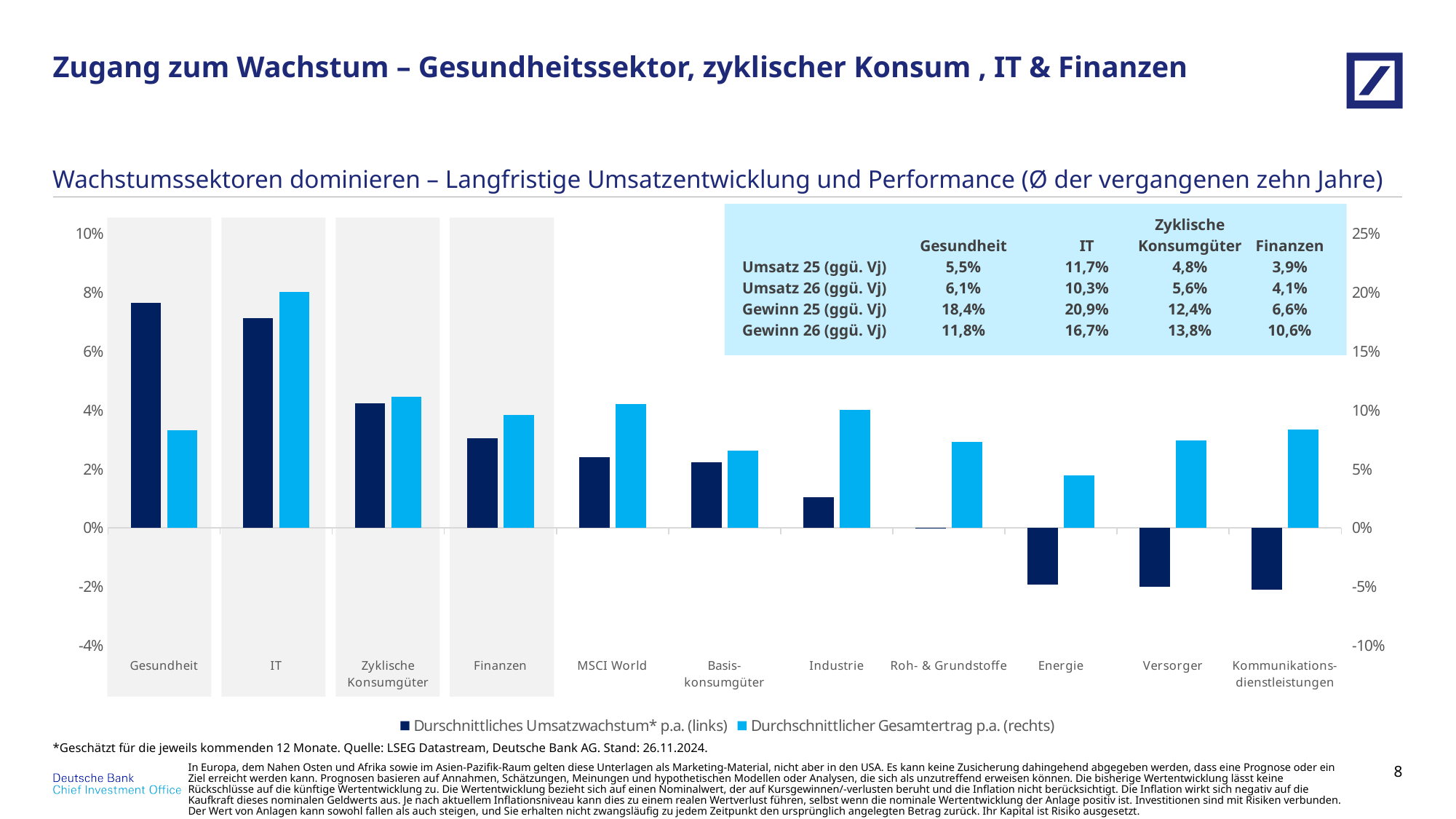
Is the Durchschnittliches Umsatzwachstum p.a. for Gesundheit greater or less than 6%? greater Which series is plotted on the right axis according to the legend? Durchschnittlicher Gesamtertrag p.a. Which has the larger Durchschnittlicher Gesamtertrag p.a., IT or Gesundheit? IT Is the Durchschnittliches Umsatzwachstum p.a. for Energie greater or less than 0%? less How many sector categories are shown on the x axis? 11 How many series does the legend list? 2 Which category has the highest Durchschnittliches Umsatzwachstum p.a. (dark blue bar)? Gesundheit Which has the larger Durchschnittliches Umsatzwachstum p.a., Gesundheit or Finanzen? Gesundheit What kind of chart is shown on the slide? bar chart Which category has the lowest Durchschnittlicher Gesamtertrag p.a. (light blue bar)? Energie Which category has the highest Durchschnittlicher Gesamtertrag p.a. (light blue bar)? IT Is the Durchschnittlicher Gesamtertrag p.a. for IT greater or less than 15%? greater